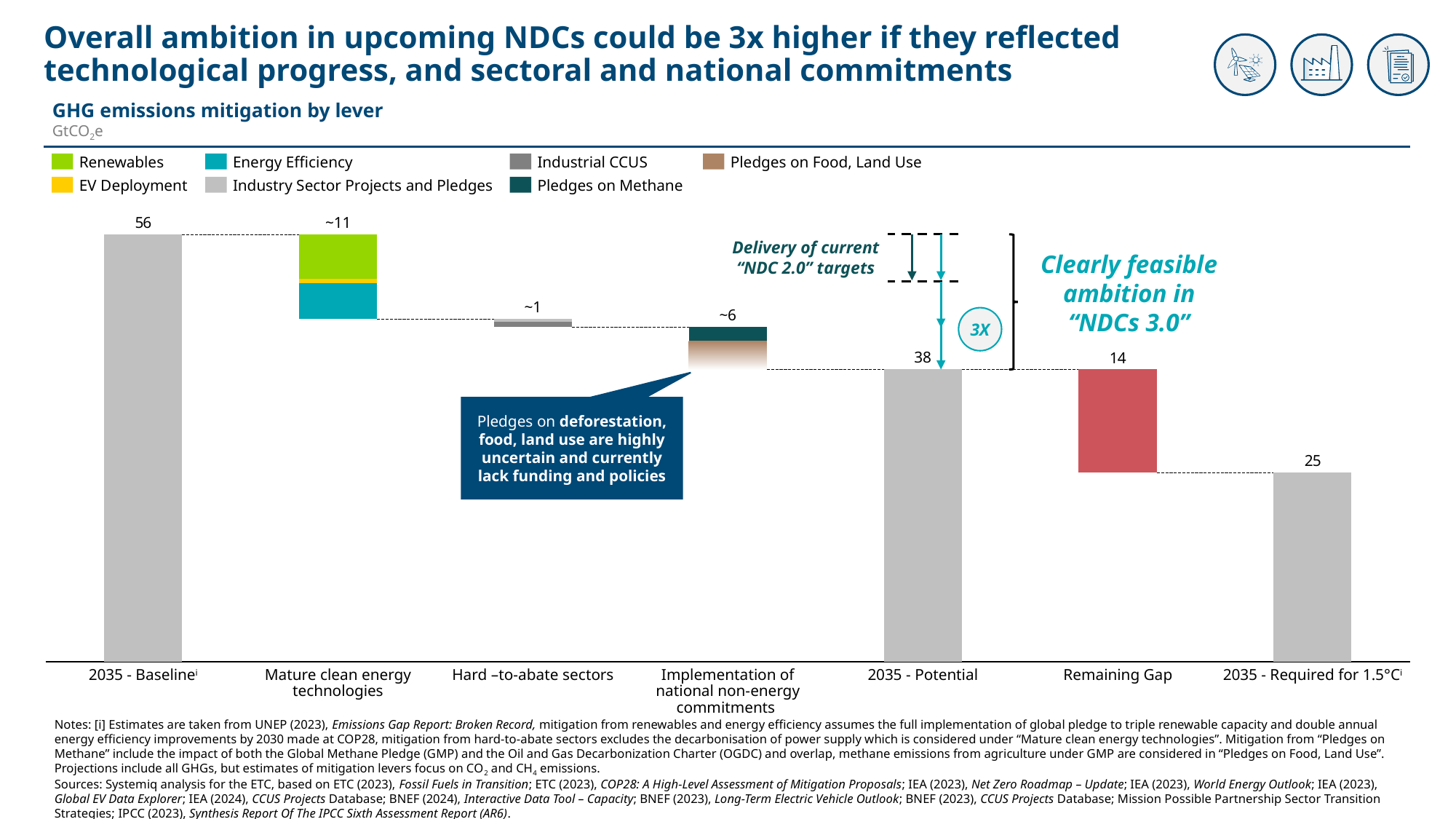
What is the title of the chart? GHG emissions mitigation by lever How many categories are shown along the x axis? 7 Which category has the highest value? 2035 - Baseline How many entries does the legend list? 7 What is the value for 2035 - Required for 1.5°C? 25 What is the difference between the 2035 - Baseline value and the 2035 - Potential value? 18 What is the value for 2035 - Baseline? 56 Which is larger, the value for 2035 - Potential or the value for 2035 - Required for 1.5°C? 2035 - Potential What value is labelled for Mature clean energy technologies? ~11 What is the value for 2035 - Potential? 38 Which category has the smallest labelled value? Hard-to-abate sectors What is the value labelled for Remaining Gap? 14